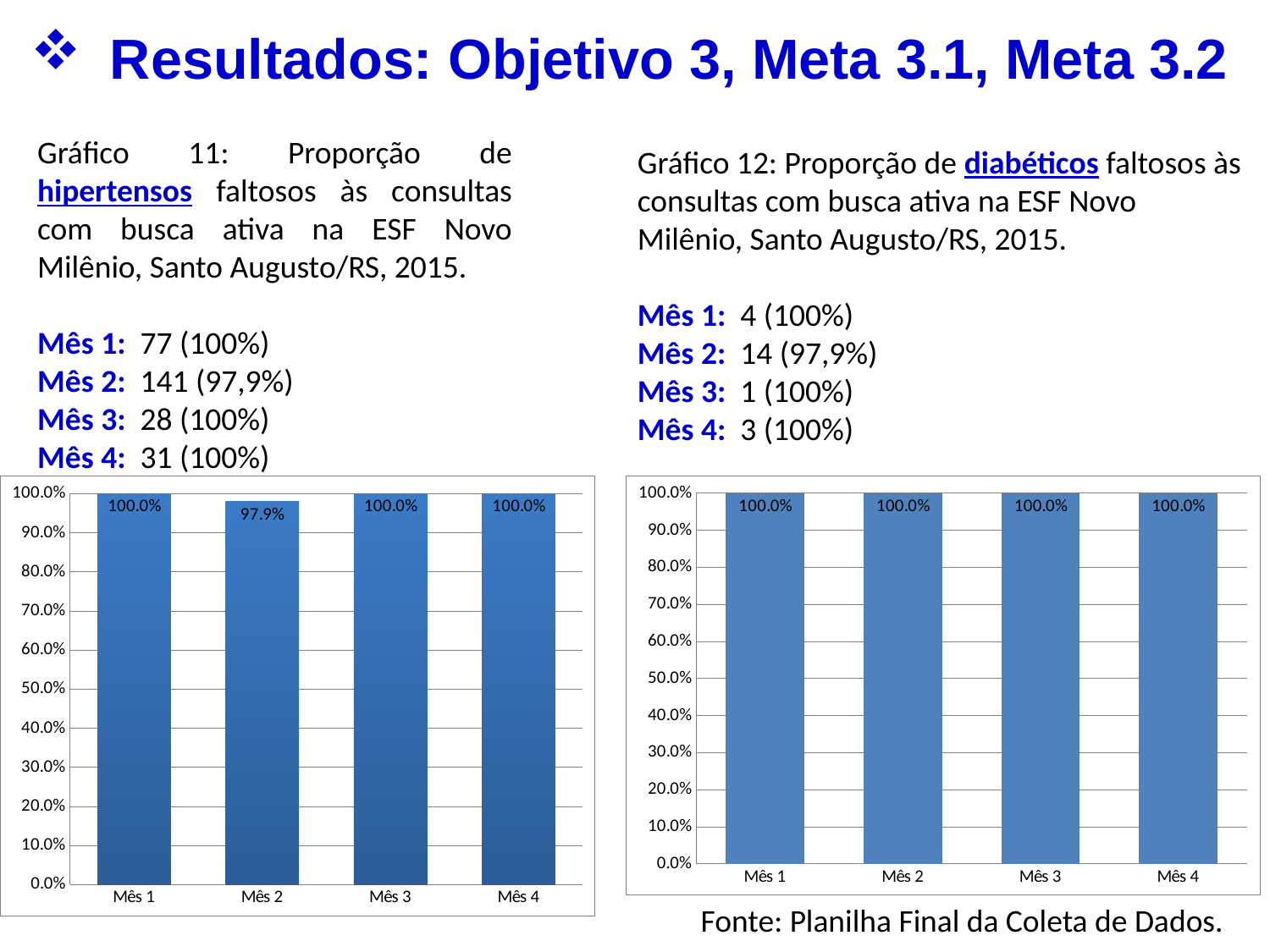
What is the label of the first category on the x axis of the left chart (Gráfico 11, hipertensos)? Mês 1 In the right chart (Gráfico 12, diabéticos), how many bars are shown? 4 In the right chart (Gráfico 12, diabéticos), what is the value for Mês 4? 100.0% In the left chart (Gráfico 11, hipertensos), what is the value for Mês 2? 97.9% In the right chart (Gráfico 12, diabéticos), what is the value for Mês 2? 100.0% In the left chart (Gráfico 11, hipertensos), what is the difference between the values for Mês 1 and Mês 2? 2.1% In the left chart (Gráfico 11, hipertensos), which is larger, the value for Mês 2 or the value for Mês 3? Mês 3 What kind of chart is the right chart (Gráfico 12, diabéticos)? Bar chart In the left chart (Gráfico 11, hipertensos), which month has the lowest value? Mês 2 In the right chart (Gráfico 12, diabéticos), is the value for Mês 3 greater or less than 90.0%? greater In the left chart (Gráfico 11, hipertensos), what is the value for Mês 1? 100.0% In the left chart (Gráfico 11, hipertensos), how many months are plotted? 4